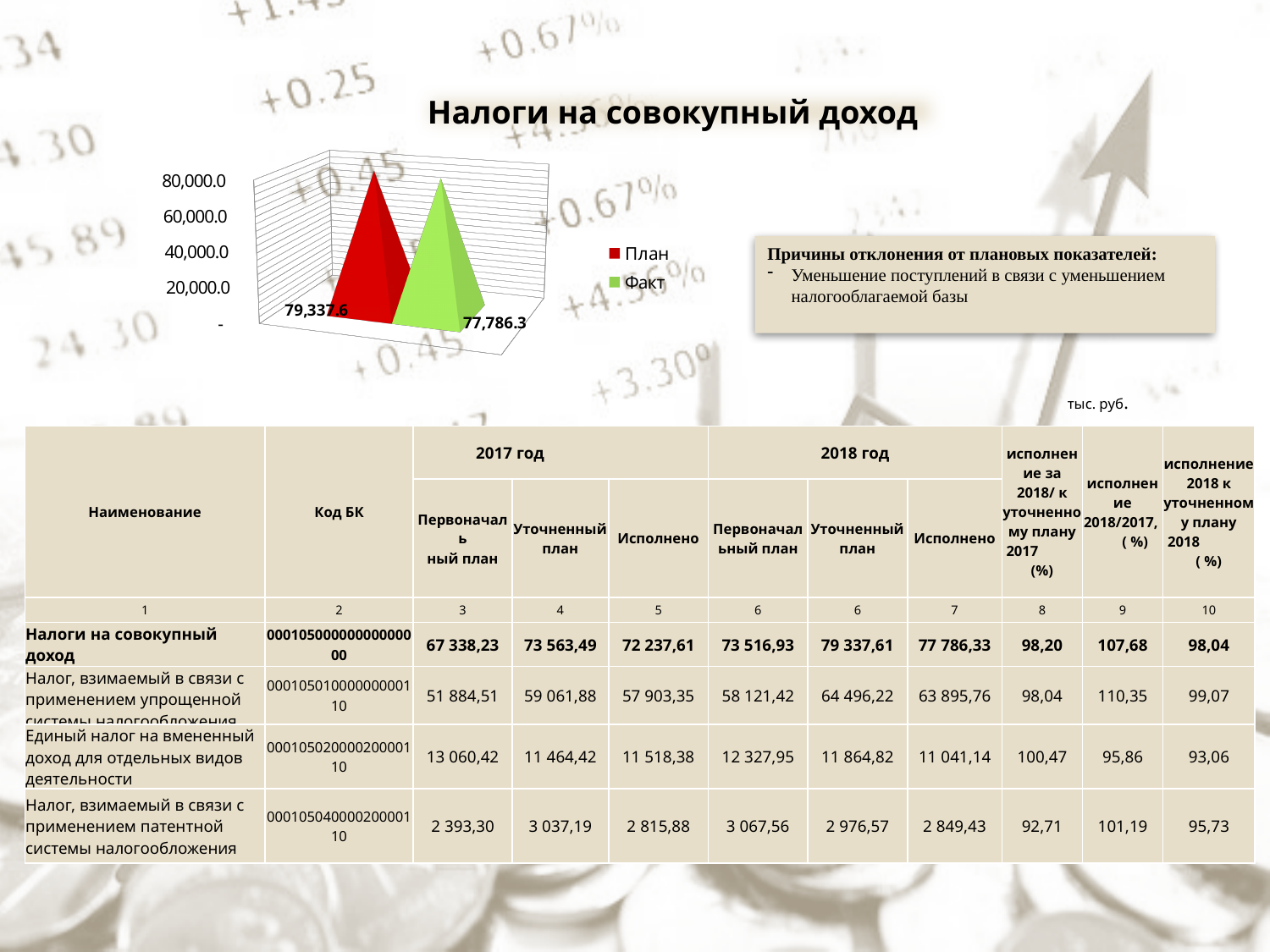
What kind of chart is shown on the slide? bar chart Is the value for Факт greater or less than 60,000.0? greater What is the value of the План series in the chart? 79,337.6 Which series has the higher value in the chart, План or Факт? План How many series does the chart legend list? 2 What is the value of the Факт series in the chart? 77,786.3 Is the value for План greater or less than 40,000.0? greater Which series has the lowest value in the chart? Факт Which series has the highest value in the chart? План What is the difference between the План value and the Факт value in the chart? 1,551.3 What colour represents the План series in the chart? red